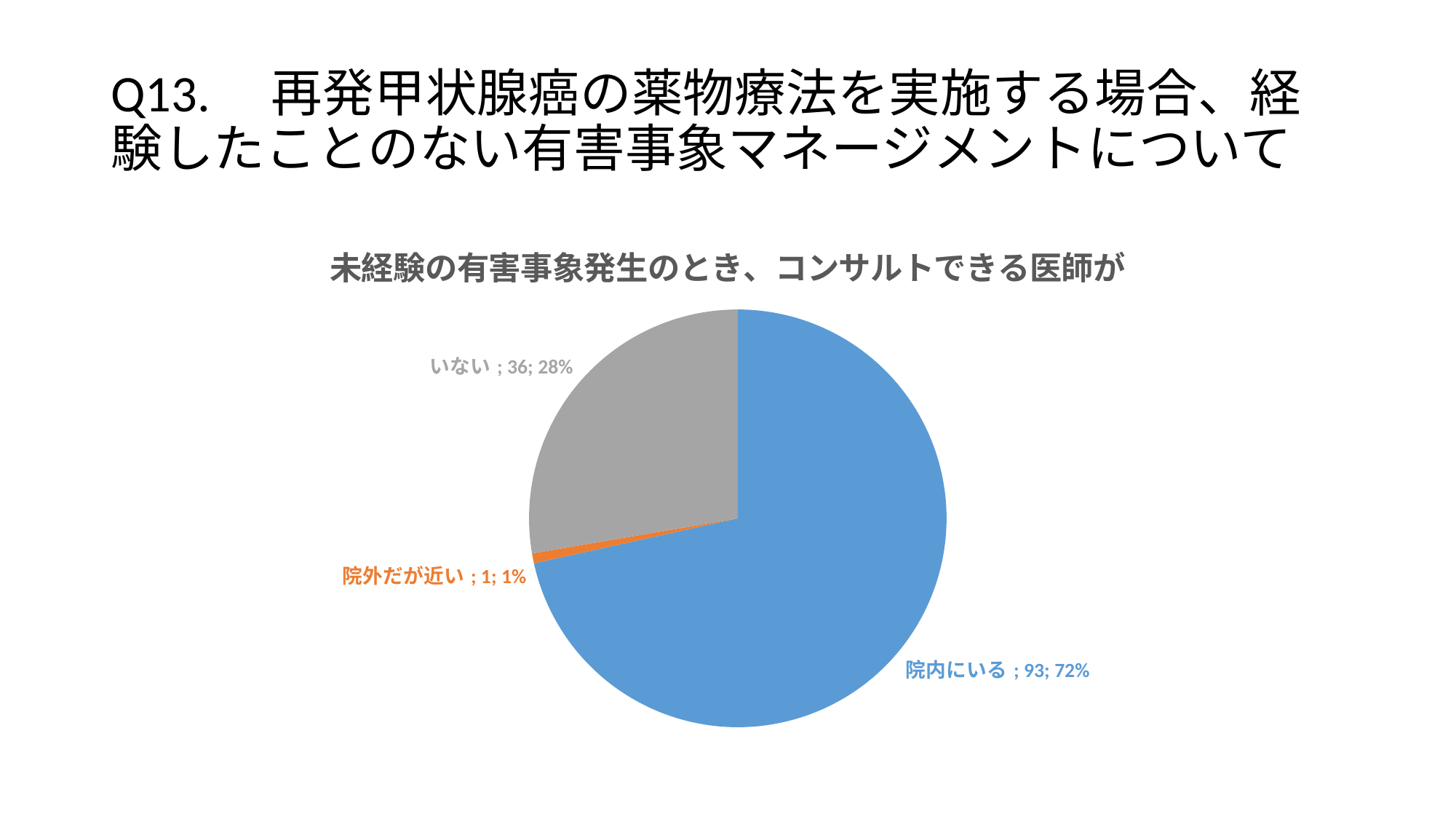
What is the count for いない? 36 What is the count for 院外だが近い? 1 How many slices does the pie chart have? 3 What is the difference between the counts for 院内にいる and いない? 57 What share of the pie does いない represent? 28% What is the title of the pie chart? 未経験の有害事象発生のとき、コンサルトできる医師が Which category has the smallest slice? 院外だが近い Which is larger, the count for いない or the count for 院外だが近い? いない What kind of chart is shown on the slide? pie chart What share of the pie does 院内にいる represent? 72% Which category has the largest slice? 院内にいる What is the count for 院内にいる? 93